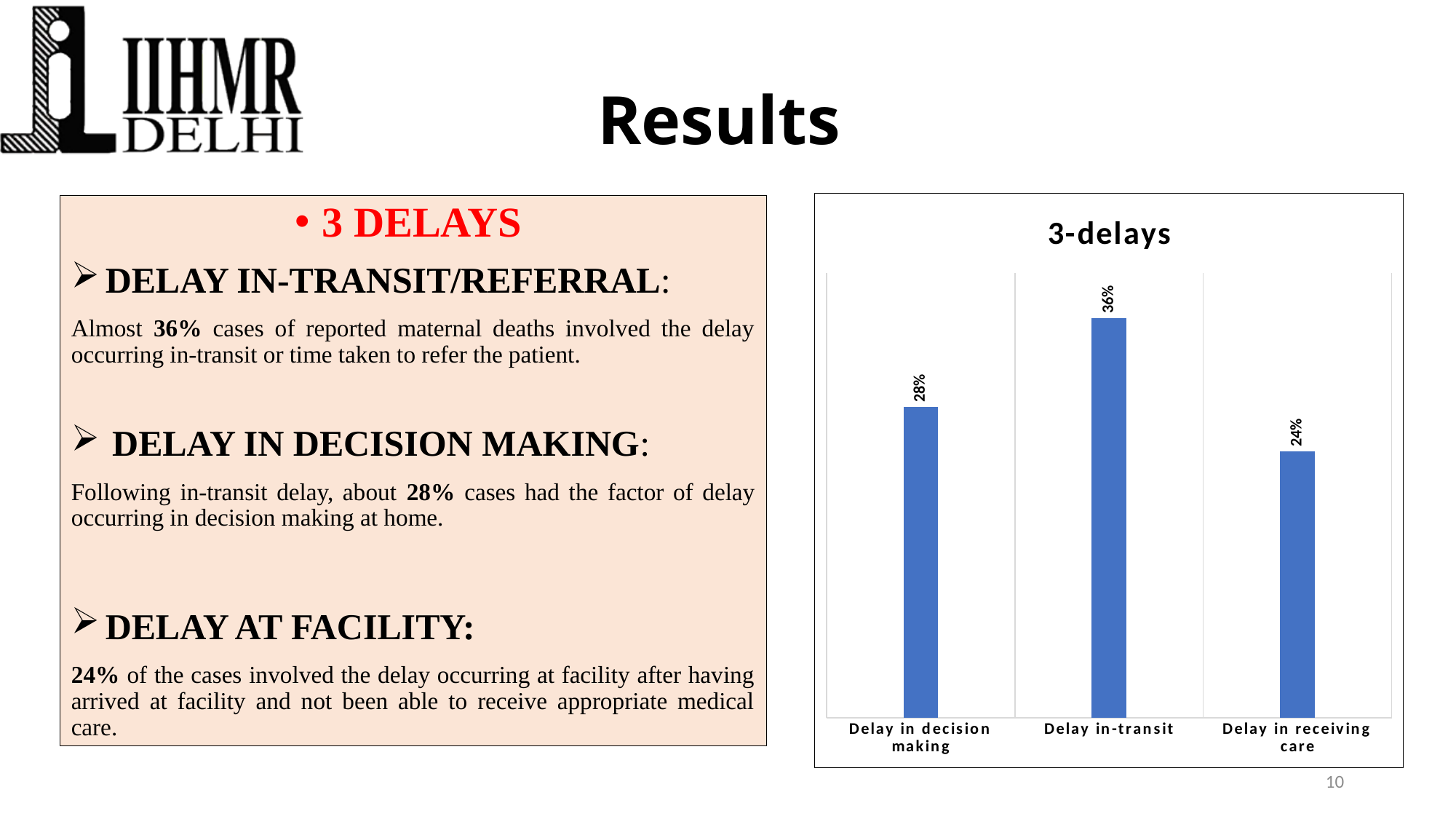
What is the title of the chart? 3-delays What is the value for Delay in decision making? 28% What colour are the bars in the chart? Blue What is the value for Delay in-transit? 36% Which category has the lowest value? Delay in receiving care What is the difference between the values for Delay in-transit and Delay in decision making? 8% How many categories are shown in the chart? 3 Which is larger, the value for Delay in decision making or the value for Delay in receiving care? Delay in decision making What kind of chart is shown on the slide? Bar chart Which category has the highest value? Delay in-transit What is the value for Delay in receiving care? 24% What is the difference between the values for Delay in decision making and Delay in receiving care? 4%